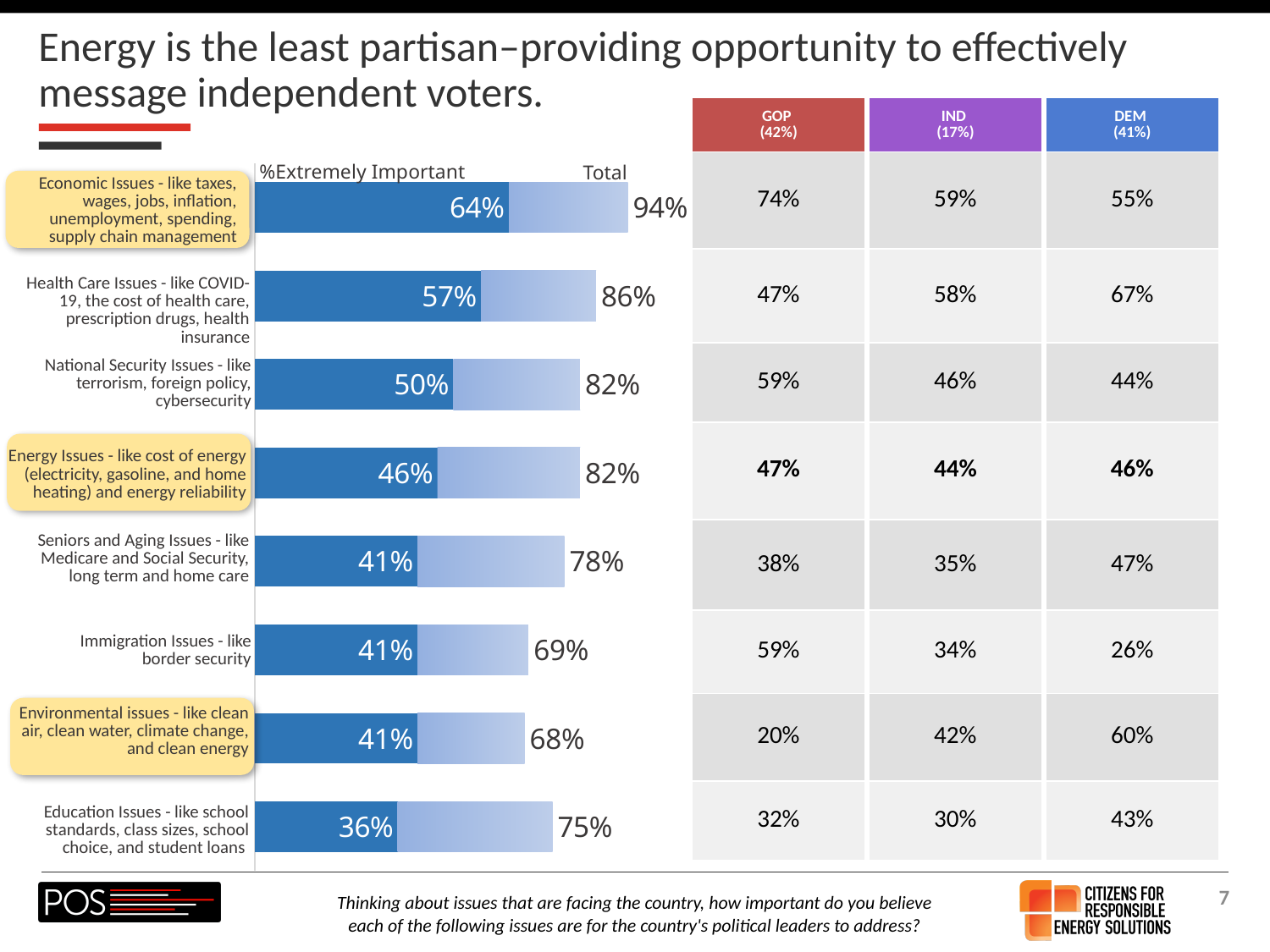
What is the difference between the Total and %Extremely Important values for National Security Issues? 32% What are the two series labels shown above the bar chart? %Extremely Important and Total What is the Total value shown for Health Care Issues? 86% What percentage of respondents rate Economic Issues as extremely important? 64% What is the difference between the Total values for Economic Issues and Education Issues? 19% Which issue has the highest Total value in the bar chart? Economic Issues Which has a higher Total value, Immigration Issues or Environmental issues? Immigration Issues What is the %Extremely Important value for Energy Issues? 46% Which issue has the lowest %Extremely Important value? Education Issues What type of chart is used to show the importance of issues? Bar chart How many issue categories are shown in the bar chart? 8